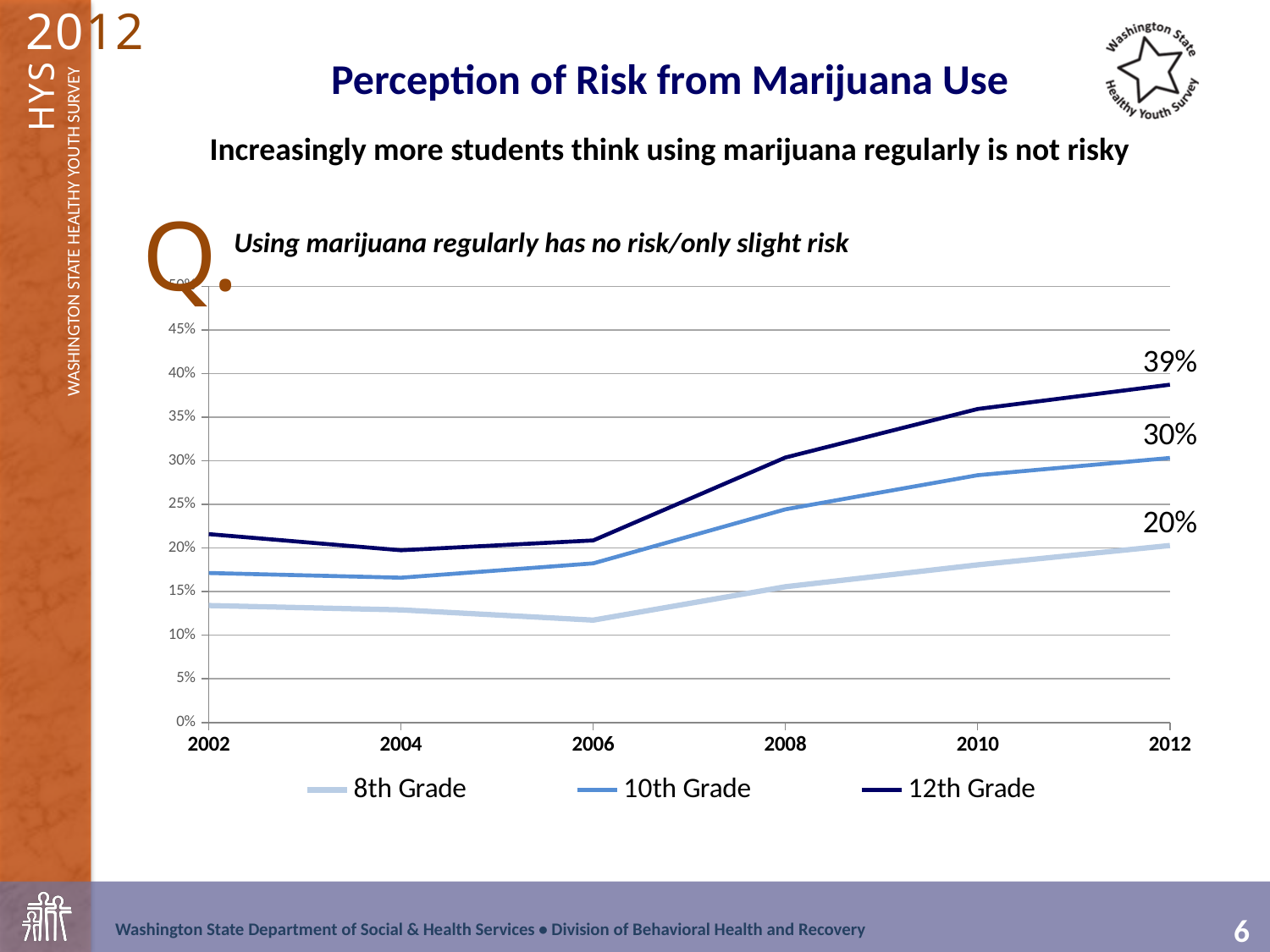
Which is larger in 2012, the 10th Grade value or the 8th Grade value? 10th Grade What is the value for 12th Grade in 2012? 39% Is the value for 12th Grade in 2004 greater or less than 25%? less How many series does the legend list? 3 What kind of chart is shown on the slide? Line chart Is the value for 8th Grade in 2006 greater or less than 15%? less Which grade has the lowest value in 2012? 8th Grade What is the value for 10th Grade in 2012? 30% What is the difference between the 12th Grade and 8th Grade values in 2012? 19 percentage points How many years are shown on the x axis? 6 Which grade has the highest value in 2012? 12th Grade What is the value for 8th Grade in 2012? 20%